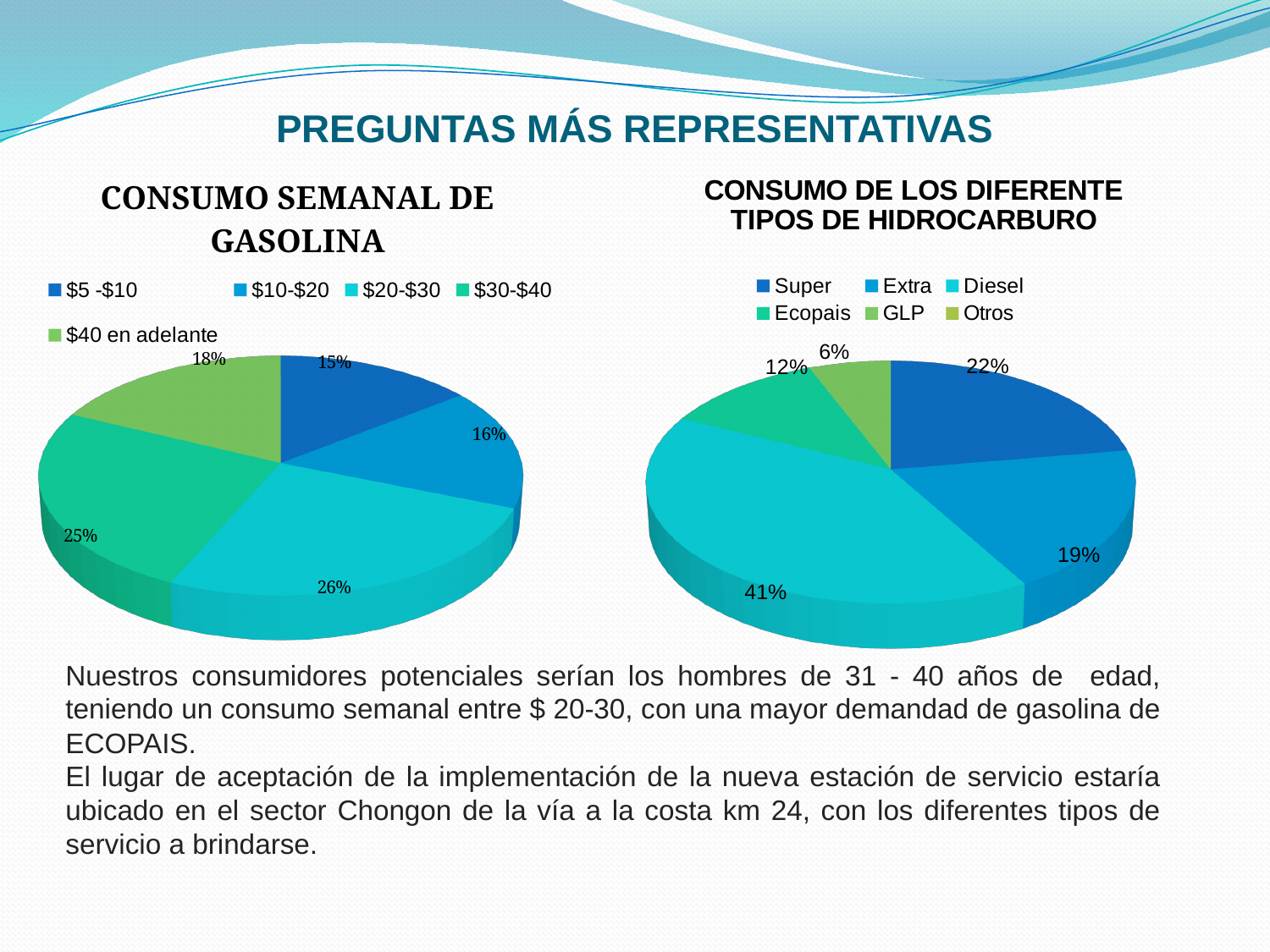
In the 'CONSUMO DE LOS DIFERENTE TIPOS DE HIDROCARBURO' chart, what share is shown for Super? 22% How many categories does the legend of the 'CONSUMO SEMANAL DE GASOLINA' chart list? 5 How many categories does the legend of the 'CONSUMO DE LOS DIFERENTE TIPOS DE HIDROCARBURO' chart list? 6 In the 'CONSUMO SEMANAL DE GASOLINA' chart, which category has the largest share? $20-$30 In the 'CONSUMO SEMANAL DE GASOLINA' chart, what share is shown for $20-$30? 26% In the 'CONSUMO DE LOS DIFERENTE TIPOS DE HIDROCARBURO' chart, what share is shown for GLP? 6% In the 'CONSUMO SEMANAL DE GASOLINA' chart, what share is shown for $5 -$10? 15% What kind of chart is the 'CONSUMO SEMANAL DE GASOLINA' chart on the left? Pie chart In the 'CONSUMO DE LOS DIFERENTE TIPOS DE HIDROCARBURO' chart, which has the larger share, Super or Extra? Super In the 'CONSUMO DE LOS DIFERENTE TIPOS DE HIDROCARBURO' chart, which category has the largest share? Diesel In the 'CONSUMO SEMANAL DE GASOLINA' chart, what is the difference between the shares for $40 en adelante and $5 -$10? 3% In the 'CONSUMO SEMANAL DE GASOLINA' chart, which category has the smallest share? $5 -$10